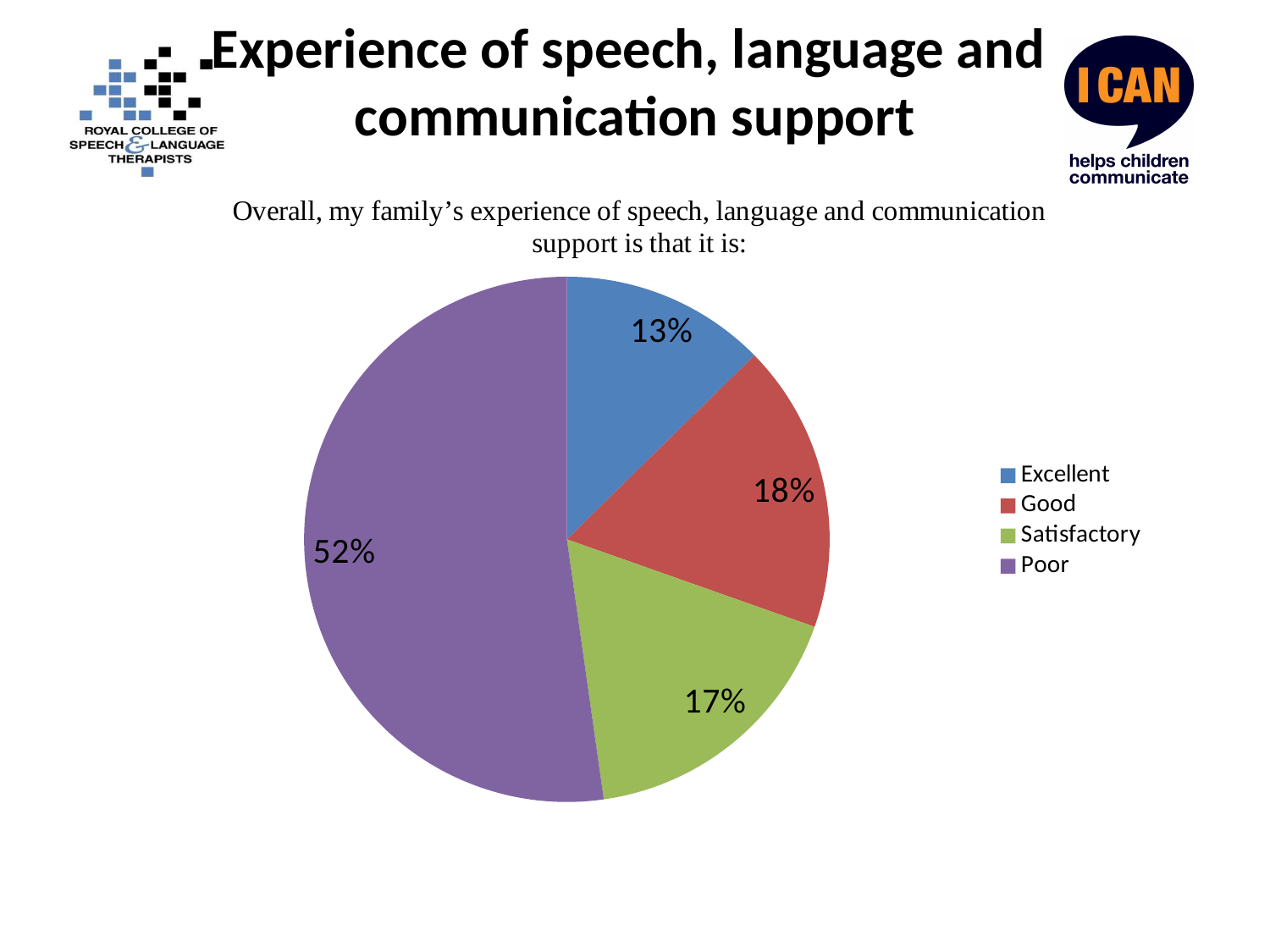
What is the combined percentage of the Excellent and Good slices? 31% What percentage of families rated their experience as Good? 18% Which rating has the largest share of the pie? Poor What percentage of families rated their experience as Poor? 52% Which is larger, the Good slice or the Satisfactory slice? Good What colour is the Poor slice of the pie? purple What percentage of families rated their experience as Satisfactory? 17% Which rating has the smallest share of the pie? Excellent What type of chart is shown on the slide? pie chart What is the difference in percentage points between the Poor and Excellent slices? 39 How many categories does the pie chart show? 4 What percentage of families rated their experience as Excellent? 13%